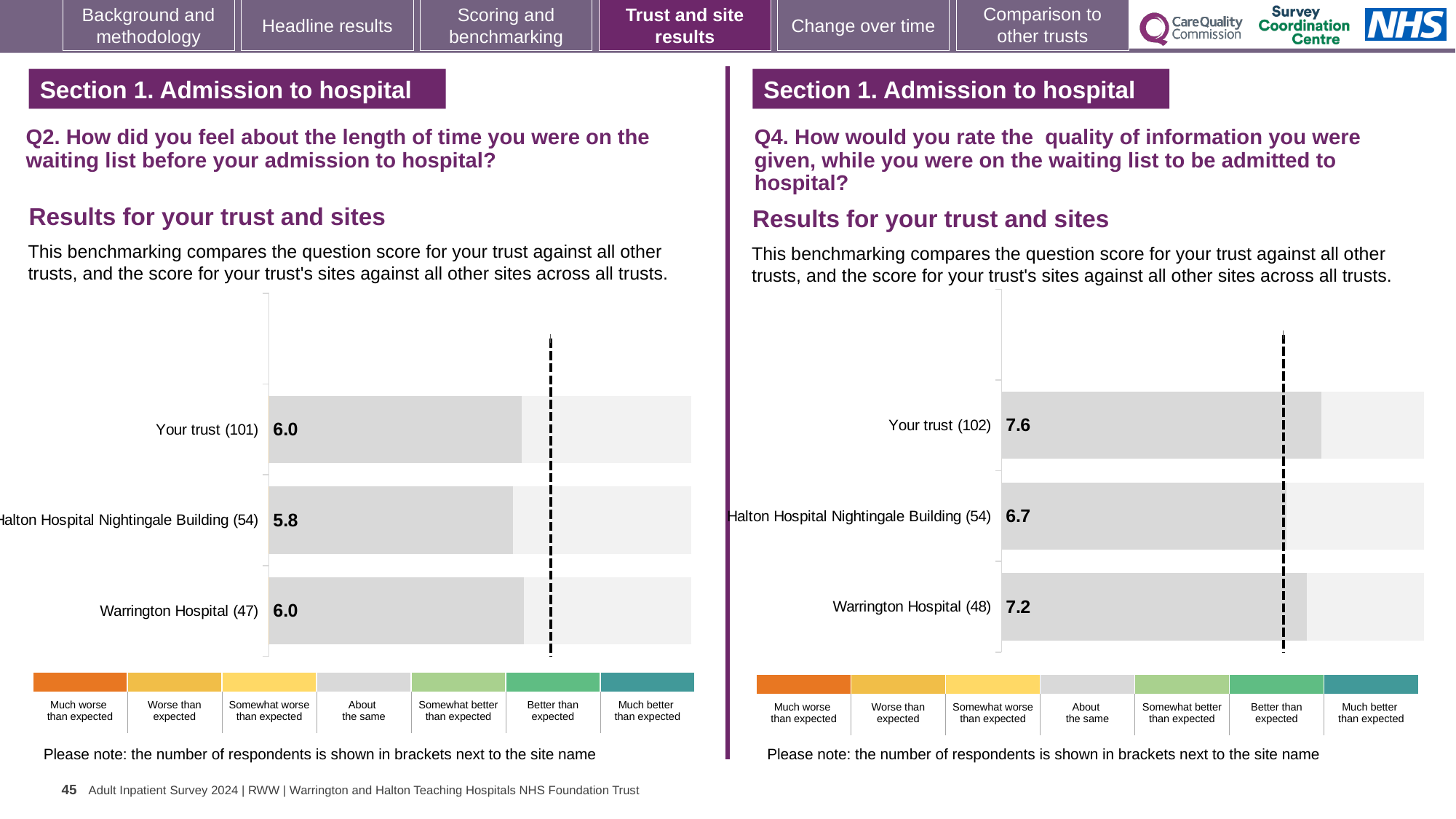
On the Q4 chart (right), what is the score for Your trust (102)? 7.6 On the Q2 chart (left), what is the score for Your trust (101)? 6.0 How many bars are plotted on the Q2 chart (left)? 3 On the Q2 chart (left), what is the score for Warrington Hospital (47)? 6.0 On the Q4 chart (right), what is the score for Halton Hospital Nightingale Building (54)? 6.7 On the Q4 chart (right), what is the difference between the scores for Your trust (102) and Warrington Hospital (48)? 0.4 On the Q2 chart (left), what is the score for Halton Hospital Nightingale Building (54)? 5.8 On the Q4 chart (right), which row has the highest score? Your trust (102) On the Q4 chart (right), which is larger: the score for Warrington Hospital (48) or Halton Hospital Nightingale Building (54)? Warrington Hospital (48) On the Q4 chart (right), what is the score for Warrington Hospital (48)? 7.2 On the Q2 chart (left), what is the difference between the scores for Your trust (101) and Halton Hospital Nightingale Building (54)? 0.2 On the Q2 chart (left), which site has the lowest score? Halton Hospital Nightingale Building (54)